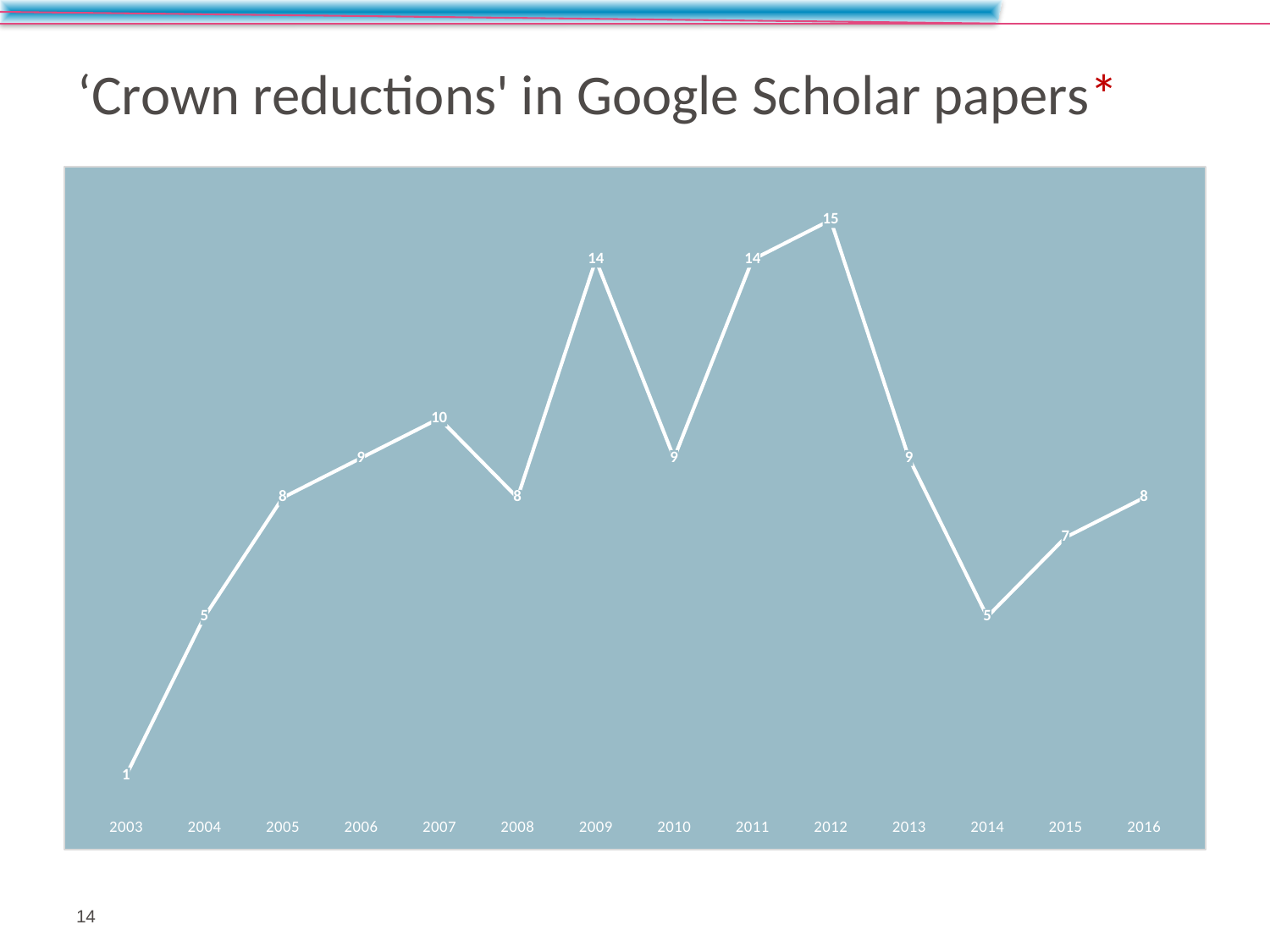
What is the value for 2003? 1 Do the values rise or fall from 2003 to 2007? Rise What is the value for 2012? 15 Which is larger, the value for 2010 or the value for 2011? 2011 What is the difference between the values for 2012 and 2013? 6 What is the difference between the values for 2007 and 2008? 2 Which year has the highest value? 2012 What kind of chart is shown on the slide? Line chart What is the value for 2009? 14 What is the value for 2014? 5 How many years are plotted on the x axis? 14 Which year has the lowest value? 2003